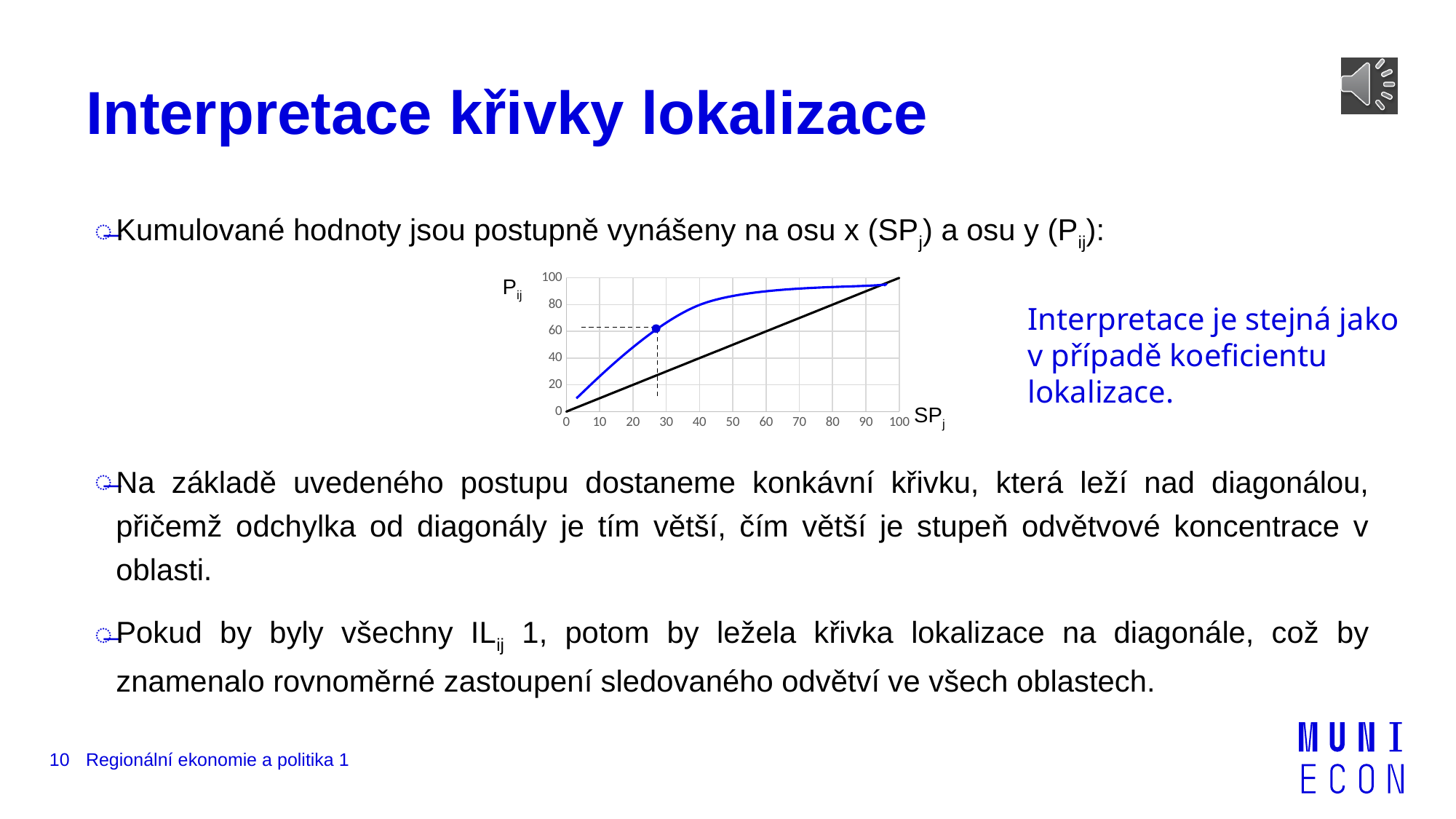
Is the value of the blue curve at SPj = 90 greater or less than 80? greater Is the Pij value of the marked point on the blue curve greater or less than 40? greater What is the label of the horizontal axis of the chart? SPj What is the highest tick value shown on the vertical axis? 100 Is the value of the blue curve at SPj = 10 greater or less than 20? greater At SPj = 40, which line is higher, the blue curve or the black diagonal? the blue curve Does the blue curve rise or fall as SPj increases? rises How many lines are plotted in the chart? 2 What kind of chart is shown on the slide? line chart What is the label of the vertical axis of the chart? Pij